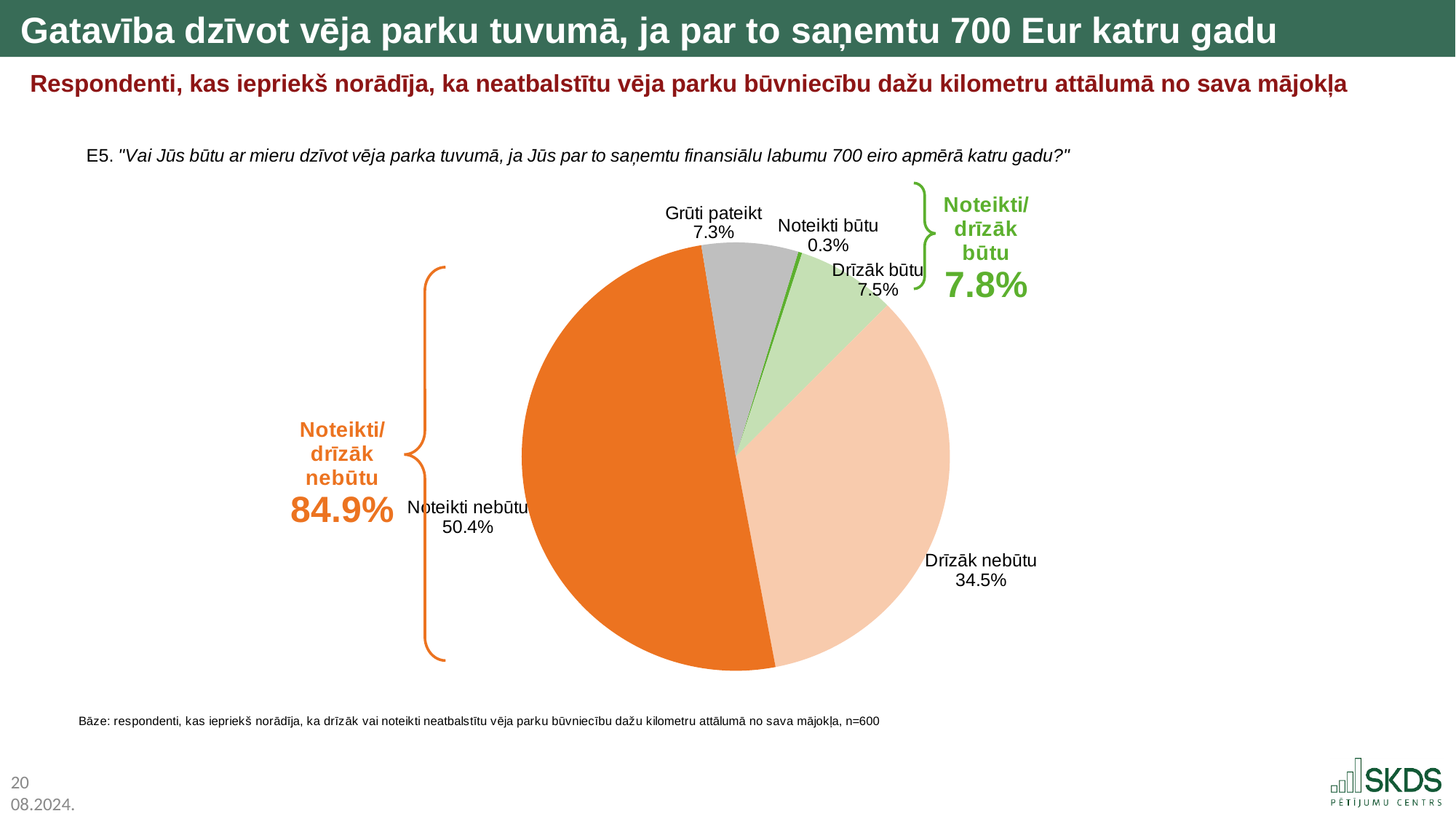
What is the value for "Drīzāk būtu"? 7.5% Which is larger, "Drīzāk būtu" or "Grūti pateikt"? Drīzāk būtu What type of chart is shown on the slide? pie chart What combined percentage is shown for "Noteikti/drīzāk nebūtu"? 84.9% How many slices does the pie chart have? 5 What is the value for "Drīzāk nebūtu"? 34.5% What is the difference between "Noteikti nebūtu" and "Drīzāk nebūtu"? 15.9% Which category has the largest share of the pie? Noteikti nebūtu Which category has the smallest share of the pie? Noteikti būtu What is the value for "Noteikti nebūtu"? 50.4% What is the value for "Noteikti būtu"? 0.3% What is the value for "Grūti pateikt"? 7.3%